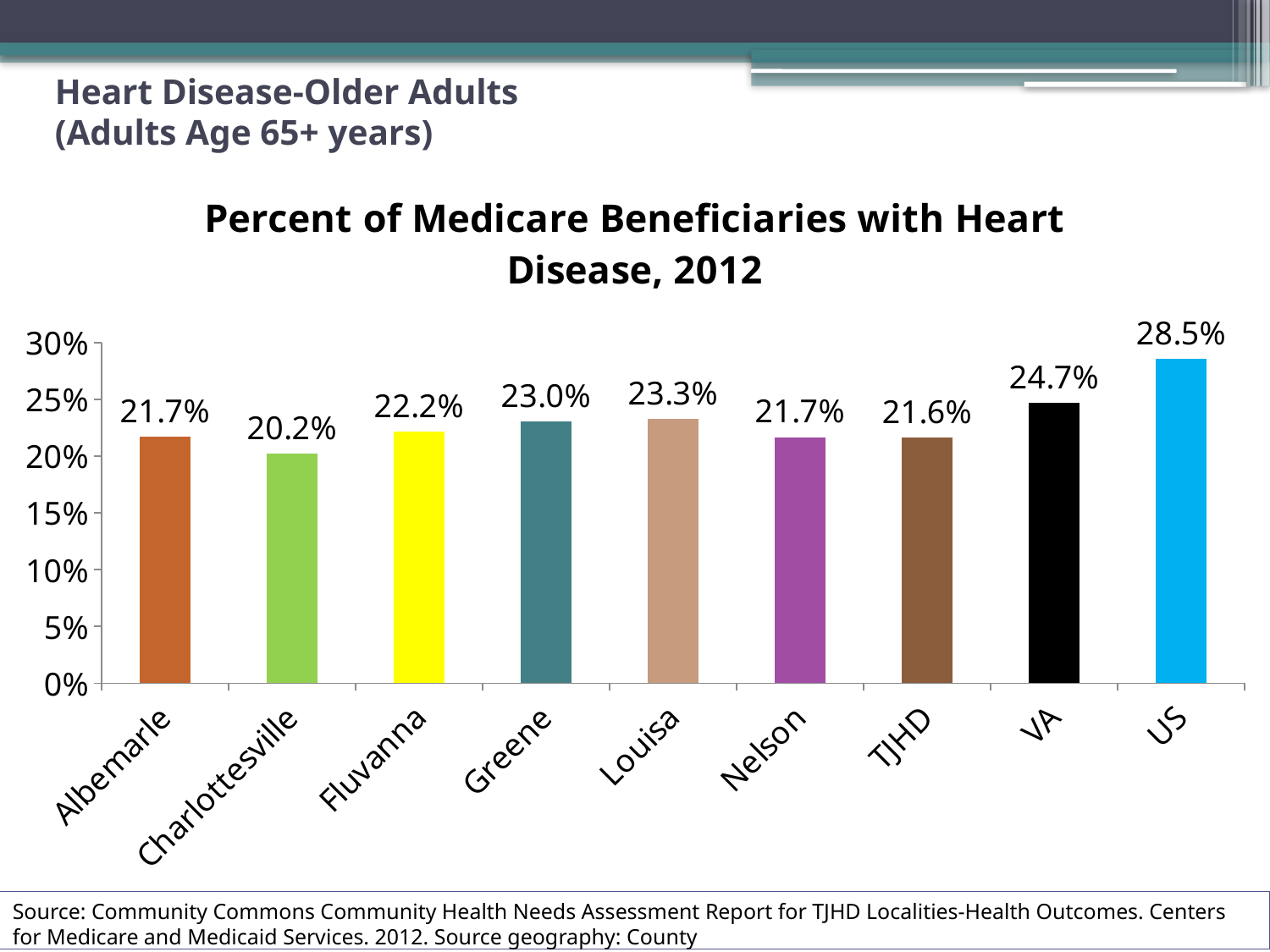
What is the value for Louisa? 23.3% Which is larger, the value for Fluvanna or the value for Louisa? Louisa What is the difference between the values for US and TJHD? 6.9% Is the value for US greater or less than 25%? greater What is the difference between the values for Greene and Charlottesville? 2.8% What kind of chart is shown on the slide? bar chart What is the value for VA? 24.7% Which category has the lowest value? Charlottesville What is the title of the chart? Percent of Medicare Beneficiaries with Heart Disease, 2012 What is the value for Charlottesville? 20.2% How many categories are shown on the x axis? 9 Which category has the highest value? US